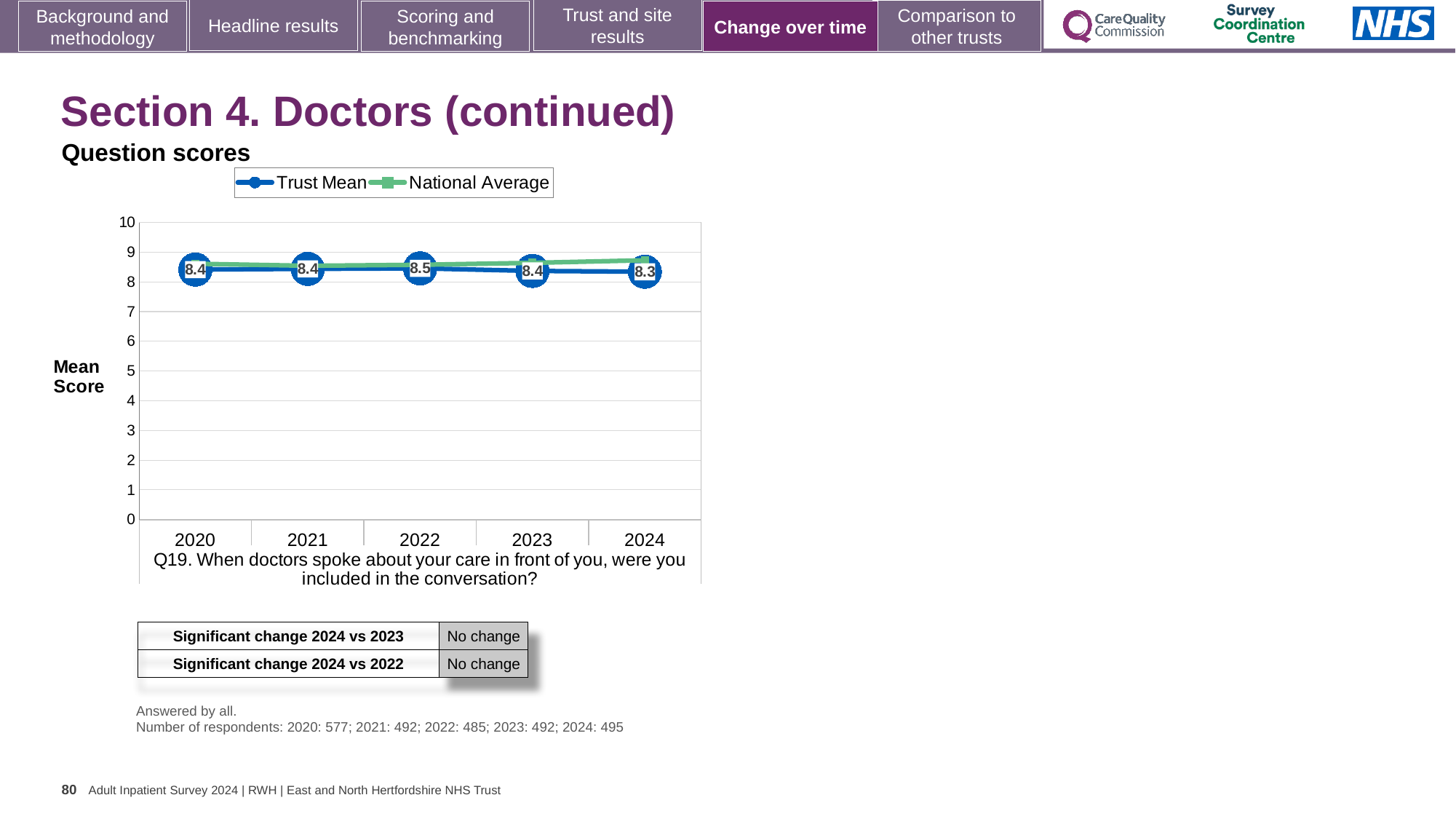
What kind of chart is shown on the slide? Line chart In which year is the Trust Mean score lowest? 2024 Is the National Average value for 2024 greater or less than 8? greater How many series does the legend list? 2 What is the Trust Mean score for 2022? 8.5 What is the Trust Mean score for 2024? 8.3 What is the difference between the Trust Mean score in 2022 and in 2024? 0.2 Which is larger, the Trust Mean score in 2021 or in 2024? 2021 In which year is the Trust Mean score highest? 2022 What is the Trust Mean score for 2020? 8.4 Does the Trust Mean score rise or fall from 2022 to 2024? Fall How many years are plotted on the x axis? 5